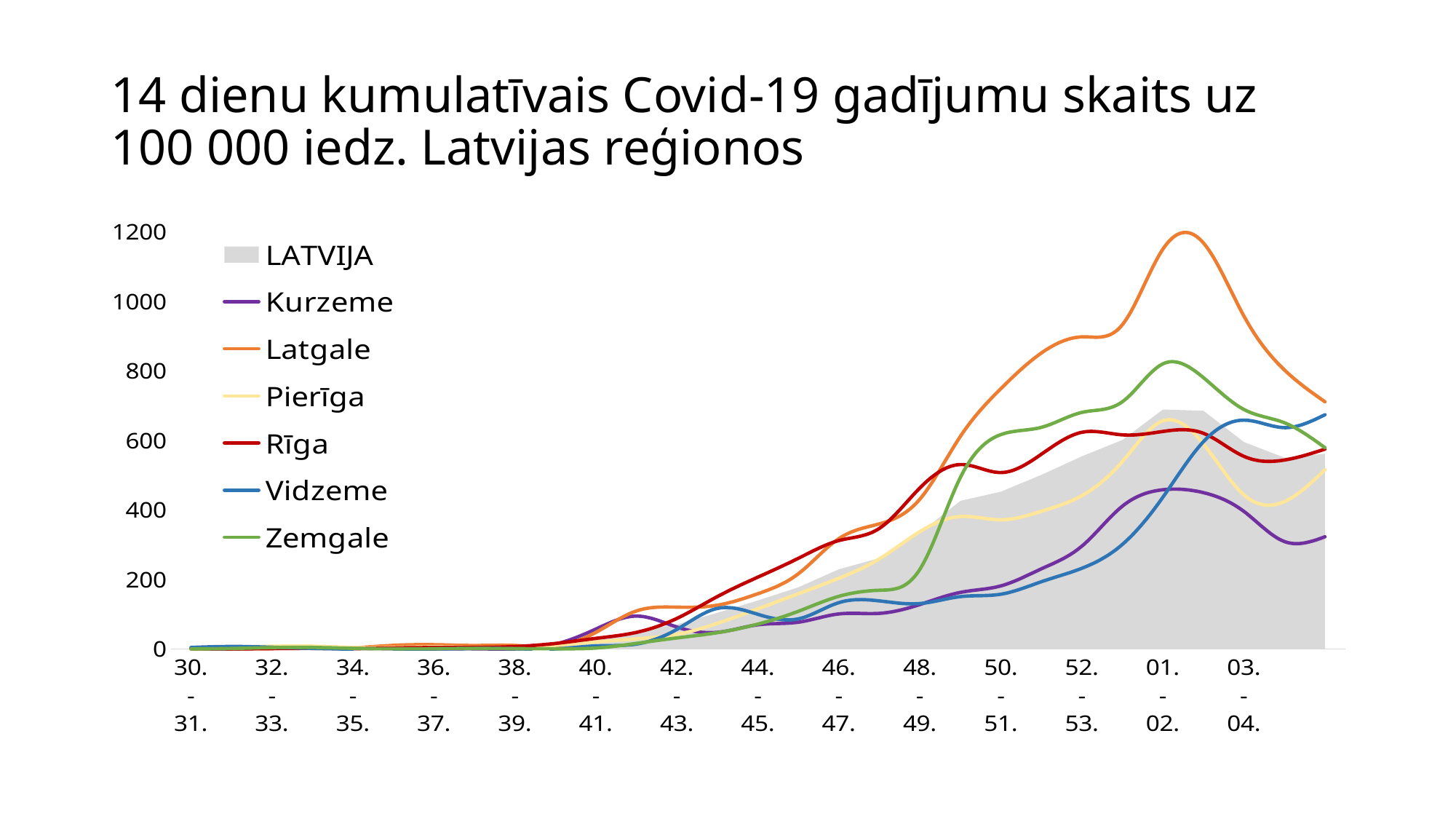
What kind of chart is shown on the slide? combination area and line chart How many series does the legend list? 7 How many labelled ticks are on the x axis? 14 Which series reaches the highest value on the chart? Latgale Is the peak value for Kurzeme greater or less than 600? less Is the peak value for Zemgale greater or less than 600? greater Does the Latgale line rise or fall from the 01.-02. label to the end of the x axis? fall Is the peak value for Latgale greater or less than 1000? greater At the last point on the x axis, which is larger, Latgale or Kurzeme? Latgale Which series is shown as a grey shaded area rather than a line? LATVIJA Does the Kurzeme line rise or fall from the 30.-31. label to the 01.-02. label? rise Which region's line has the lowest peak value on the chart? Kurzeme